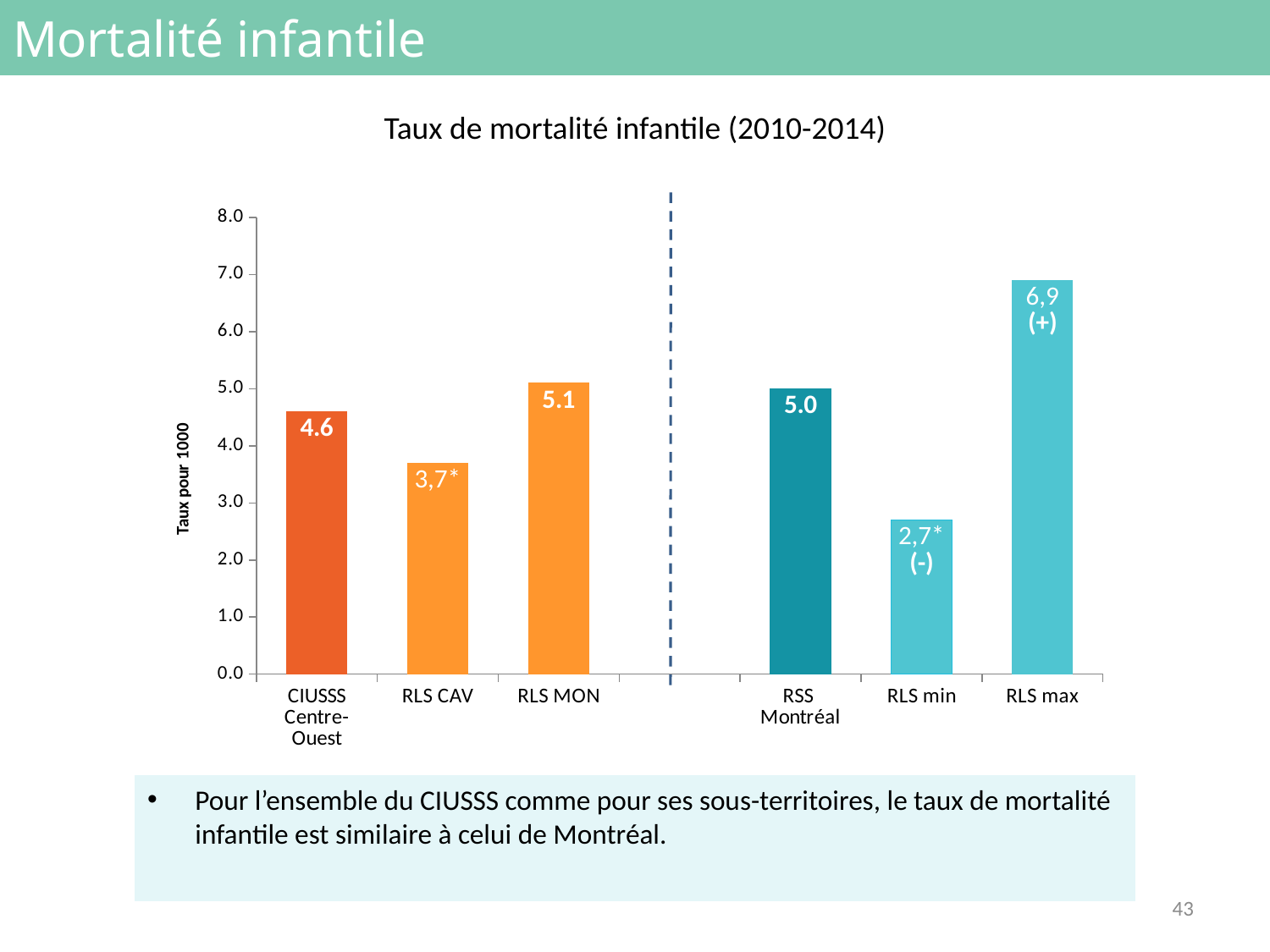
What is the value shown for RSS Montréal? 5.0 Which category has the highest infant mortality rate in the chart? RLS max What value is labelled on the bar for RLS max? 6,9 How many categories are shown on the x axis of the chart? 6 Which category has the lowest infant mortality rate in the chart? RLS min What is the difference between the values for RLS MON and CIUSSS Centre-Ouest? 0.5 Which is larger, the value for RLS MON or the value for RLS CAV? RLS MON What is the value shown for RLS MON? 5.1 What is the title of the chart? Taux de mortalité infantile (2010-2014) What value is labelled on the bar for RLS CAV? 3,7* What type of chart is shown on the slide? Bar chart What is the infant mortality rate shown for CIUSSS Centre-Ouest? 4.6